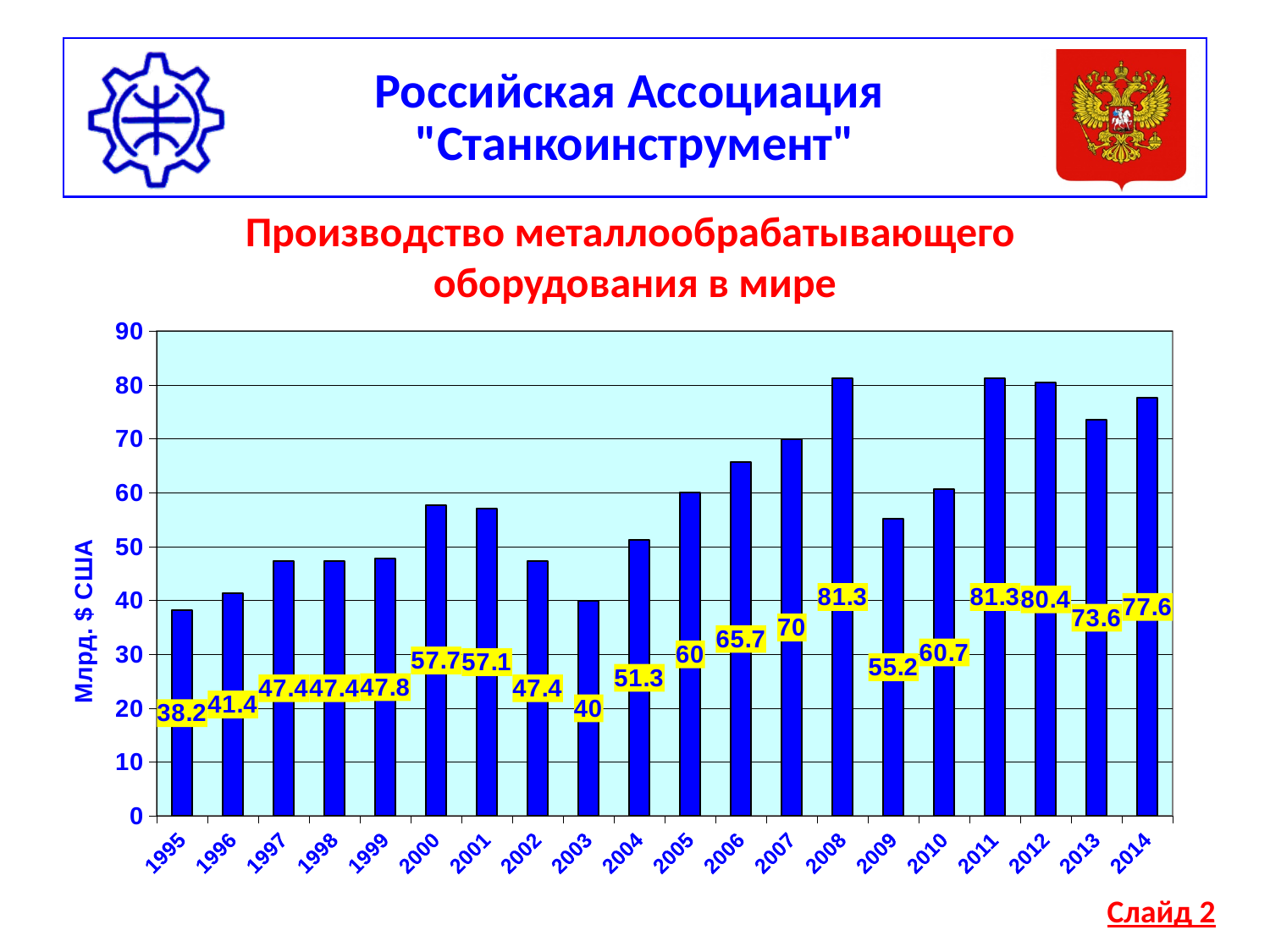
What type of chart is shown on the slide? bar chart What is the label of the vertical axis? Млрд. $ США What is the difference between the values for 2014 and 2013? 4 Which year has the lowest value? 1995 What is the value for 2008? 81.3 What is the value for 1999? 47.8 How many years are shown on the x axis? 20 What is the difference between the values for 2008 and 2009? 26.1 Is the value for 2007 greater or less than 60? greater What is the value for 2014? 77.6 Which is larger, the value for 2012 or the value for 2013? 2012 What is the value for 2003? 40